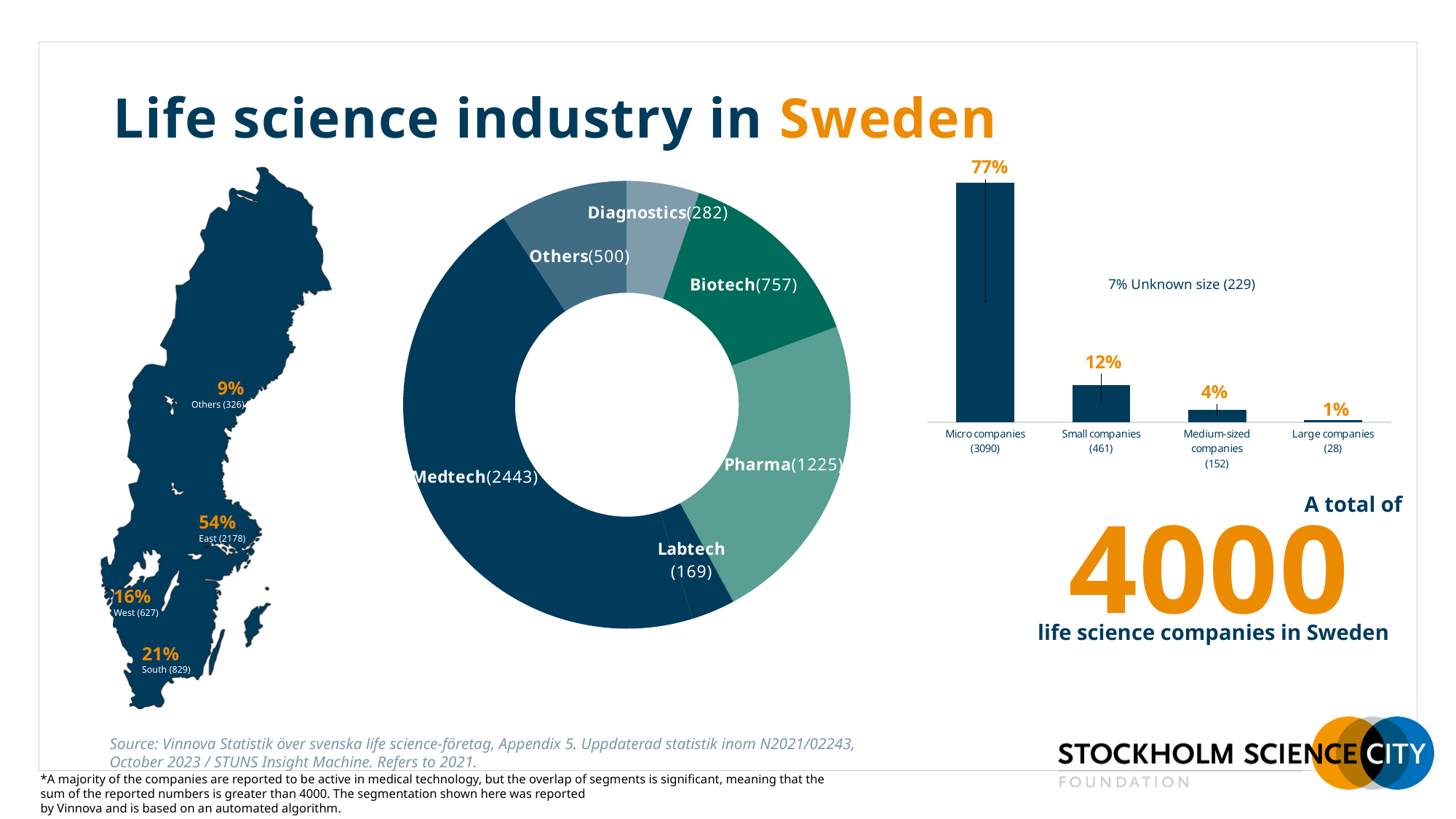
In the bar chart of company sizes, which category has the lowest share? Large companies (1%) What kind of chart is used to show company sizes on the right of the slide? Bar chart In the donut chart, how many companies are in the Biotech segment? 757 How many segments does the donut chart show? 6 In the donut chart, how many companies are in the Medtech segment? 2443 In the bar chart of company sizes, what is the difference in percentage points between micro companies and small companies? 65 In the donut chart, which segment has the most companies? Medtech (2443) In the bar chart of company sizes, how many small companies are there? 461 In the bar chart of company sizes, what percentage of companies are micro companies? 77% On the map of Sweden, which region has the largest share of life science companies? East (54%) In the donut chart, how many more companies are in Pharma than in Biotech? 468 In the donut chart, which segment has the fewest companies? Labtech (169)